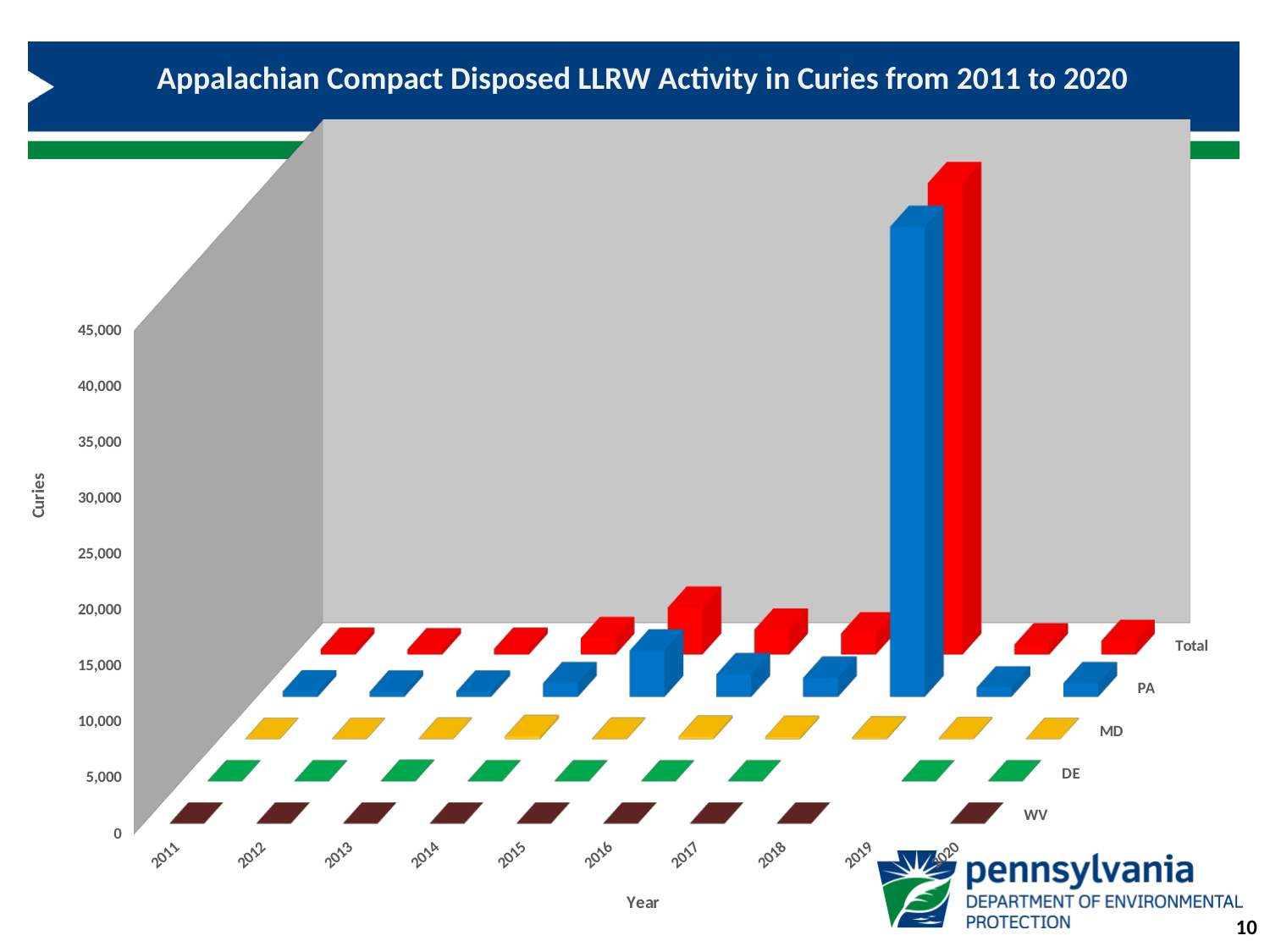
Is the PA value for 2019 greater or less than 30,000? less What is the label on the vertical axis? Curies How many series does the chart show? 5 Is the Total value for 2011 greater or less than 5,000? less How many years are shown on the x axis? 10 What kind of chart is shown on the slide? bar chart What is the title of the chart? Appalachian Compact Disposed LLRW Activity in Curies from 2011 to 2020 Which year has the highest Total value? 2018 Which year has the highest PA value? 2018